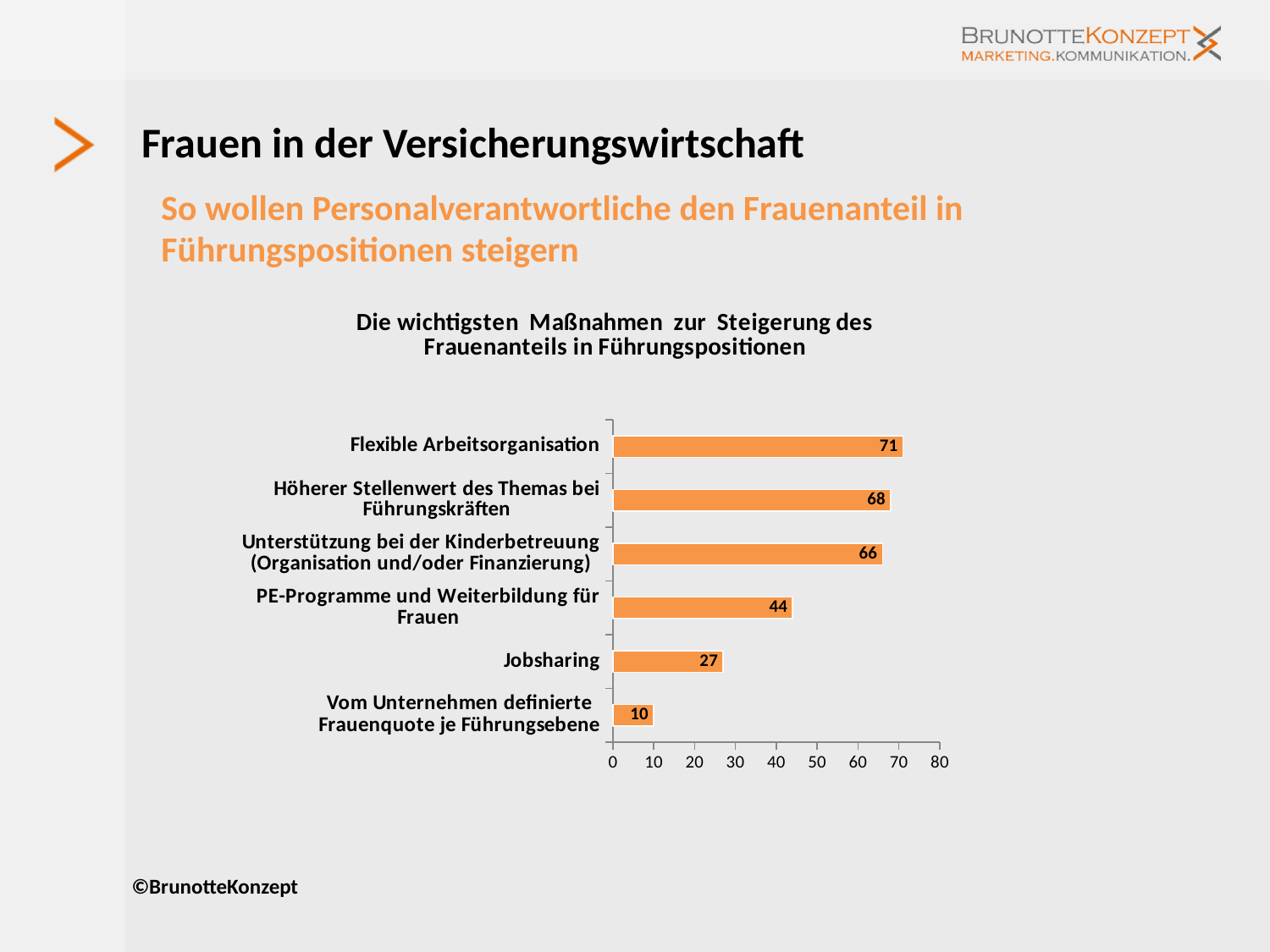
What is the title of the chart? Die wichtigsten Maßnahmen zur Steigerung des Frauenanteils in Führungspositionen What is the value for PE-Programme und Weiterbildung für Frauen? 44 What is the difference between the values for Flexible Arbeitsorganisation and Jobsharing? 44 Which category has the highest value? Flexible Arbeitsorganisation How many categories are shown in the chart? 6 What is the value for Jobsharing? 27 What kind of chart is shown on the slide? Bar chart Which category has the lowest value? Vom Unternehmen definierte Frauenquote je Führungsebene What is the value for Flexible Arbeitsorganisation? 71 What is the difference between the values for Höherer Stellenwert des Themas bei Führungskräften and PE-Programme und Weiterbildung für Frauen? 24 What is the value for Unterstützung bei der Kinderbetreuung (Organisation und/oder Finanzierung)? 66 Which is larger, the value for Jobsharing or the value for PE-Programme und Weiterbildung für Frauen? PE-Programme und Weiterbildung für Frauen